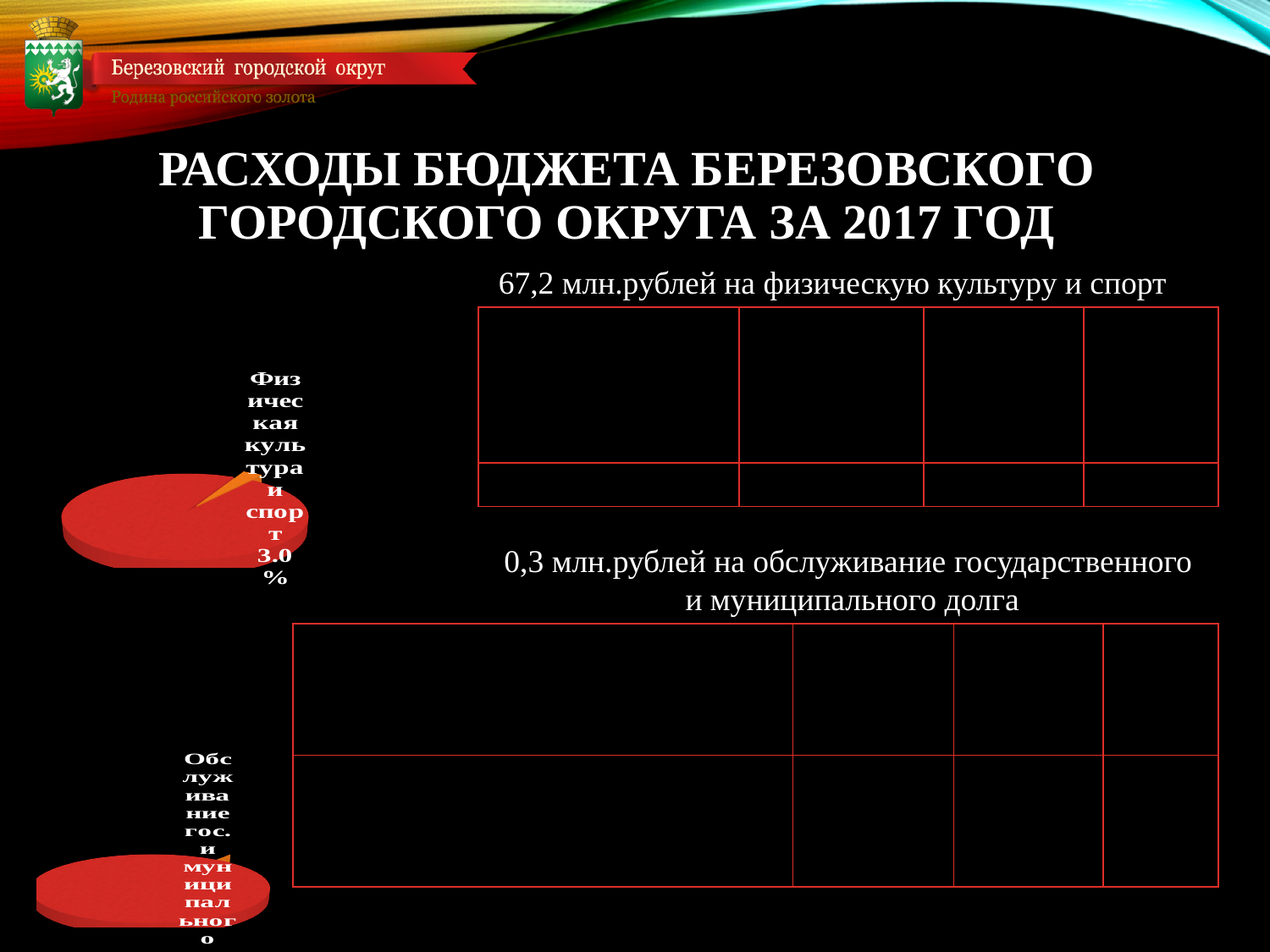
What kind of chart is the lower chart on the left side of the slide? pie chart What colour is the main body of the pie in the upper chart? red In the lower pie chart, is the slice labelled "Обслуживание гос. и муниципального" larger or smaller than the rest of the pie? smaller What kind of chart is the upper chart on the left side of the slide? pie chart In the upper pie chart, is the labelled slice "Физическая культура и спорт" larger or smaller than the rest of the pie? smaller In the upper pie chart, which slice is labelled with a percentage? Физическая культура и спорт In the upper pie chart, what share is labelled for the slice "Физическая культура и спорт"? 3.0% In the upper pie chart, is the share for "Физическая культура и спорт" greater or less than 50%? less